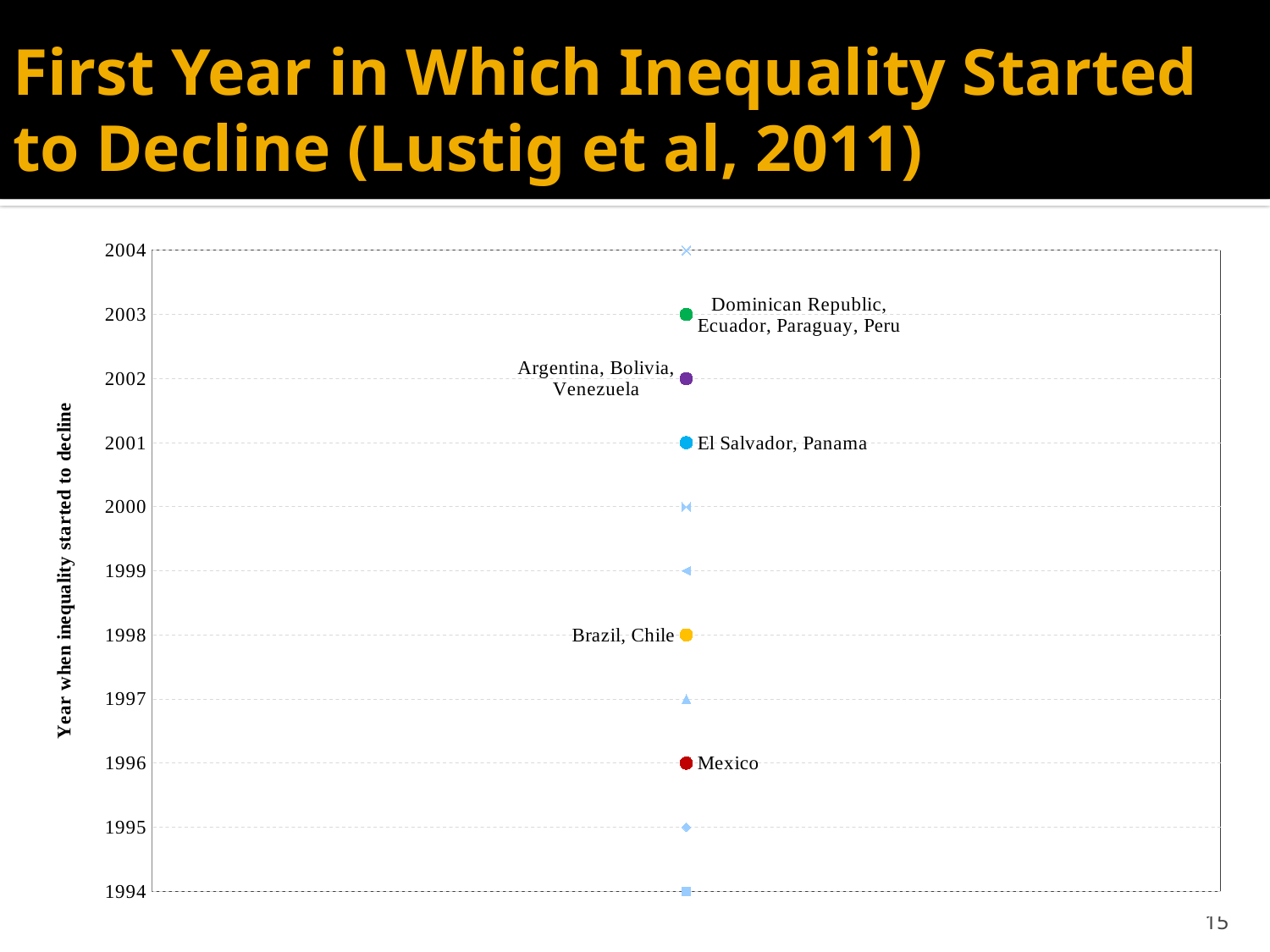
What year is shown for Argentina, Bolivia and Venezuela? 2002 Which labelled country or group has the earliest year in which inequality started to decline? Mexico Which labelled group has the latest year in which inequality started to decline? Dominican Republic, Ecuador, Paraguay, Peru How many labelled country groups are shown on the chart? 5 In what year did inequality start to decline in Mexico according to the chart? 1996 Did inequality start to decline earlier in Mexico or in Brazil and Chile? Mexico What is the title of the vertical axis? Year when inequality started to decline In which year did inequality start to decline in El Salvador and Panama? 2001 What kind of chart is shown on the slide? Scatter chart In which year did inequality start to decline in the Dominican Republic, Ecuador, Paraguay and Peru? 2003 What year is plotted for Brazil and Chile? 1998 How many years separate Mexico's start of decline from that of the Dominican Republic, Ecuador, Paraguay and Peru? 7